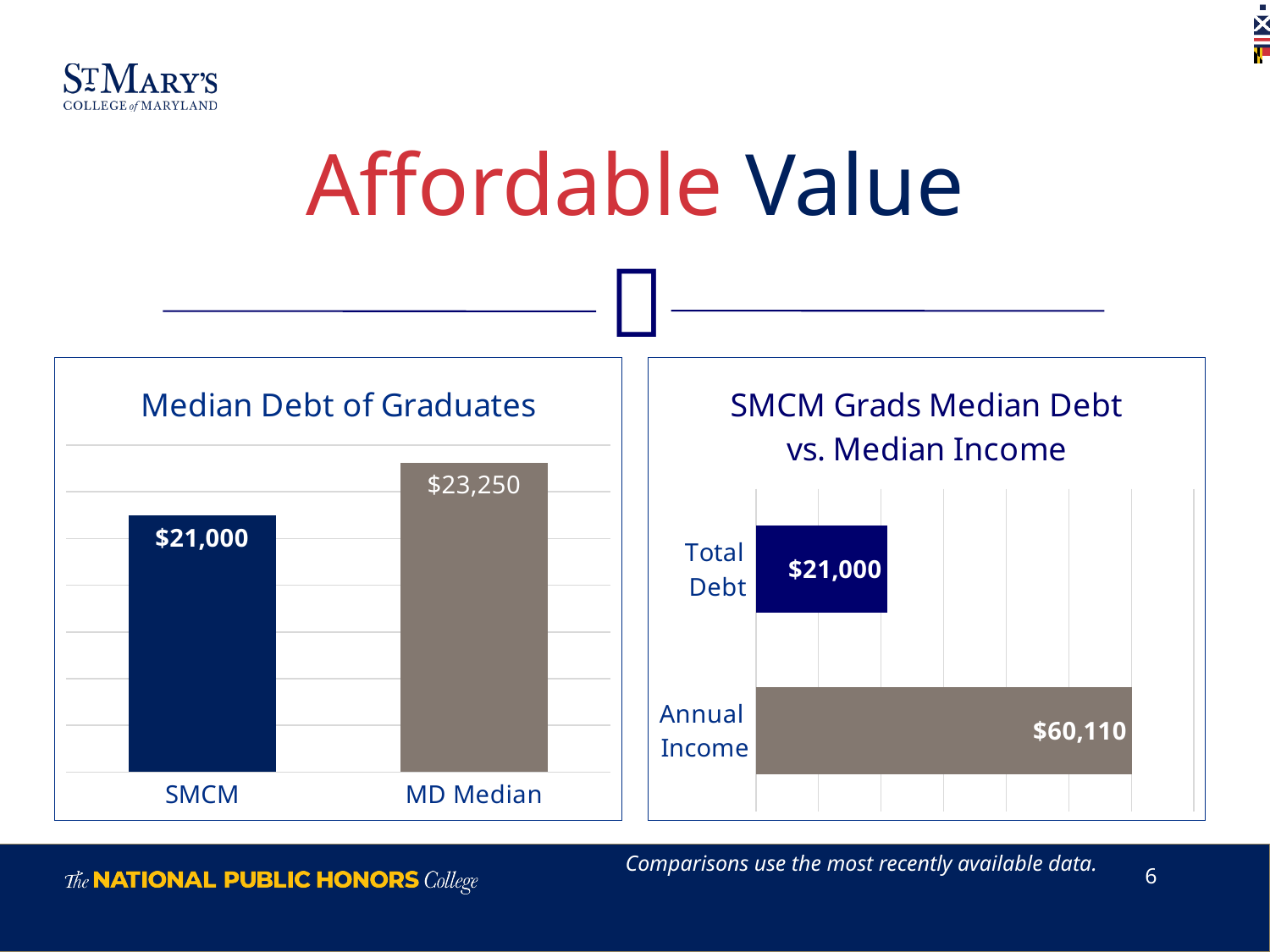
In the 'Median Debt of Graduates' chart, which category has the higher median debt? MD Median In the 'Median Debt of Graduates' chart, what is the median debt for SMCM? $21,000 In the 'Median Debt of Graduates' chart, how many categories are shown? 2 In the 'Median Debt of Graduates' chart, what is the difference between the MD Median and SMCM values? $2,250 In the 'SMCM Grads Median Debt vs. Median Income' chart, what is the value for Total Debt? $21,000 In the 'SMCM Grads Median Debt vs. Median Income' chart, which category has the lower value? Total Debt In the 'SMCM Grads Median Debt vs. Median Income' chart, what is the difference between Annual Income and Total Debt? $39,110 In the 'SMCM Grads Median Debt vs. Median Income' chart, is the value for Annual Income larger or smaller than the value for Total Debt? Larger What is the title of the chart on the right side of the slide? SMCM Grads Median Debt vs. Median Income In the 'Median Debt of Graduates' chart, what is the value for MD Median? $23,250 What type of chart is the 'Median Debt of Graduates' chart? Bar chart In the 'SMCM Grads Median Debt vs. Median Income' chart, what is the value for Annual Income? $60,110